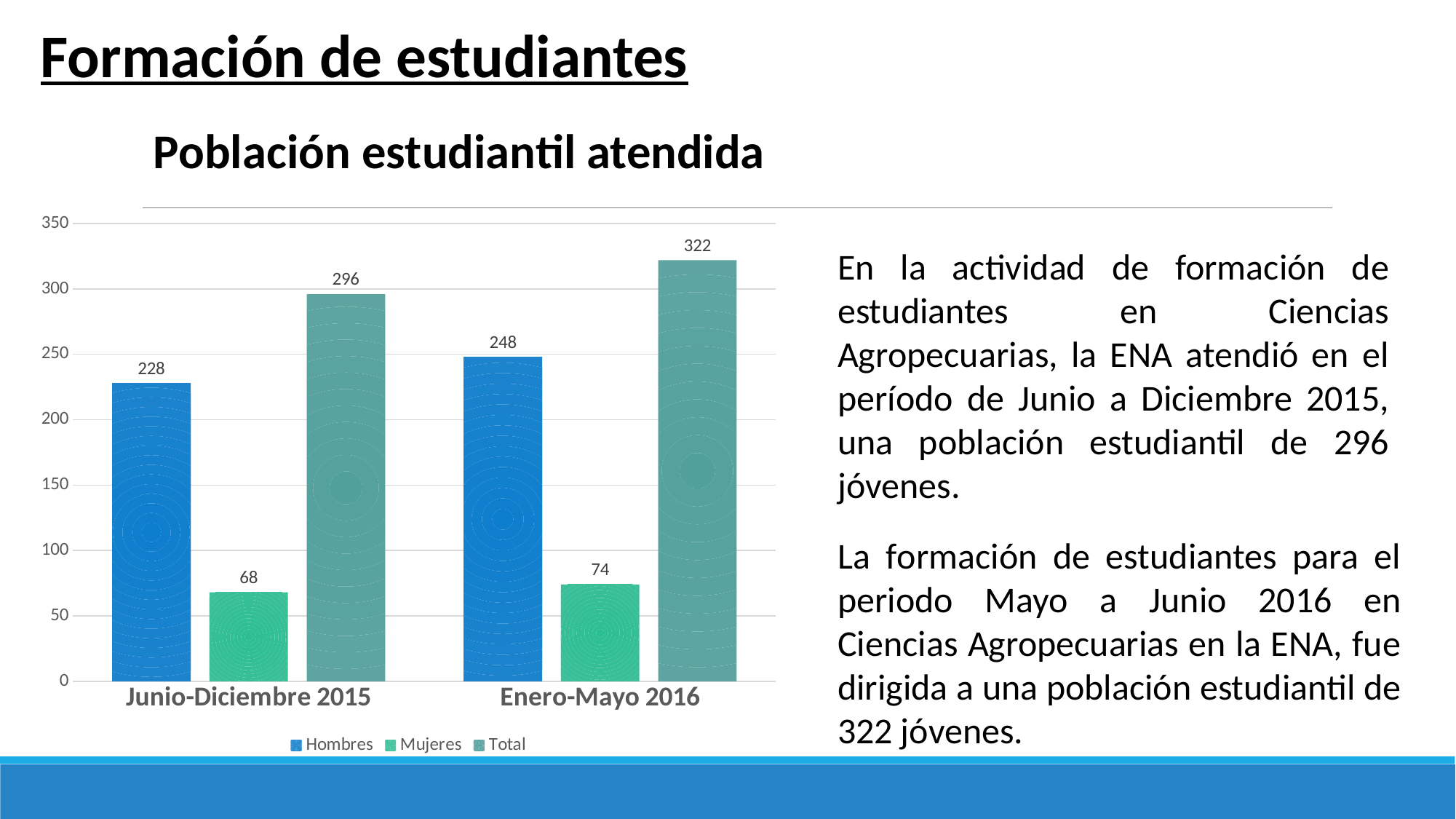
How many periods (categories) are shown on the x axis? 2 What is the value for Mujeres in Enero-Mayo 2016? 74 What is the value for Hombres in Junio-Diciembre 2015? 228 Which series has the lowest value in Junio-Diciembre 2015? Mujeres What is the difference between the Hombres values for Enero-Mayo 2016 and Junio-Diciembre 2015? 20 What is the Total value for Enero-Mayo 2016? 322 What is the difference between the Total values for the two periods? 26 What is the title of the chart? Población estudiantil atendida How many series does the legend list? 3 Which period has the higher Total value? Enero-Mayo 2016 Which is larger: Mujeres in Junio-Diciembre 2015 or Mujeres in Enero-Mayo 2016? Mujeres in Enero-Mayo 2016 What kind of chart is shown on the slide? Bar chart